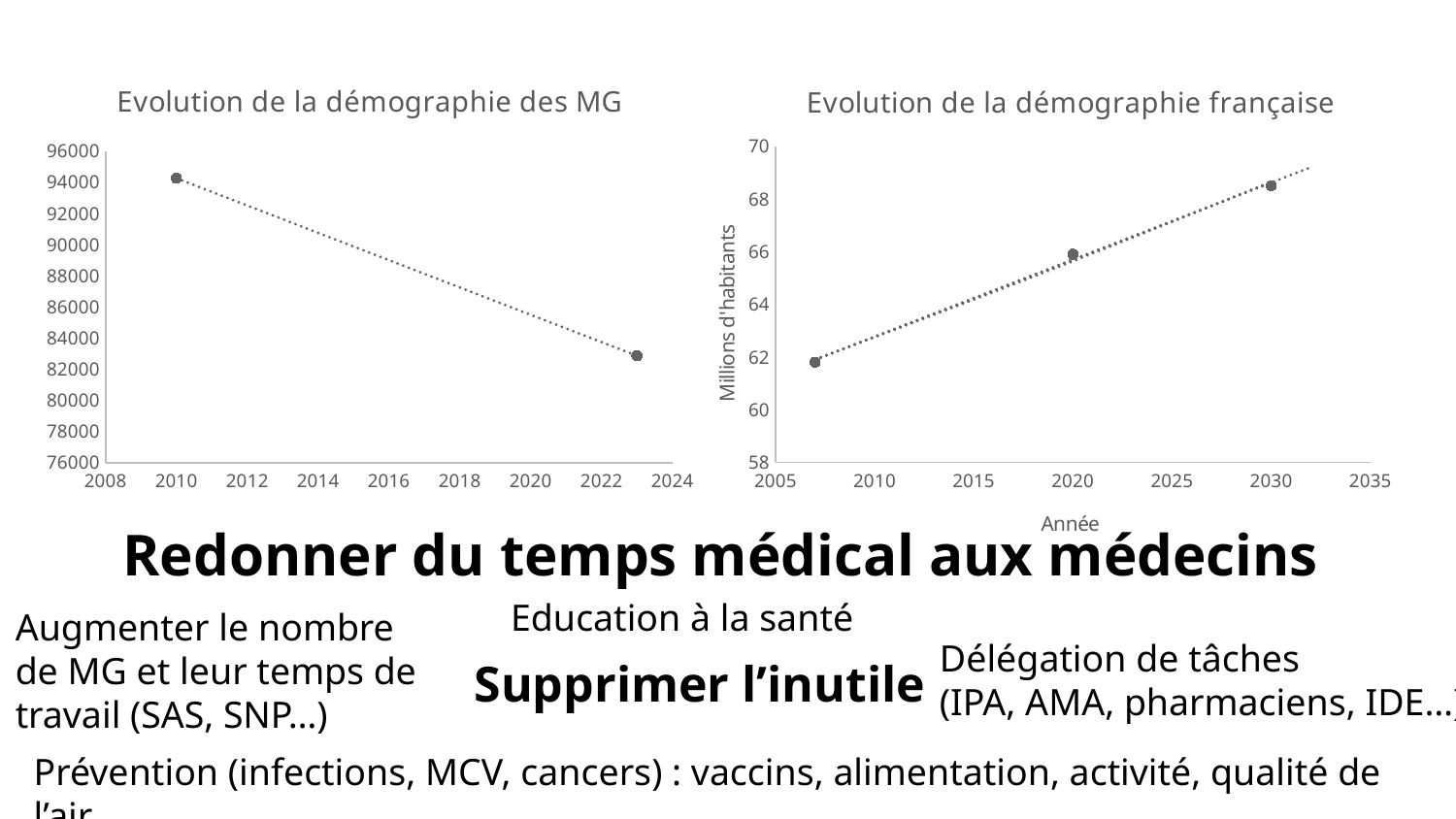
What is the title of the chart on the left of the slide? Evolution de la démographie des MG In the chart titled "Evolution de la démographie française", is the value for 2030 greater or less than 68? greater In the chart titled "Evolution de la démographie française", what is the label of the vertical axis? Millions d'habitants In the chart titled "Evolution de la démographie des MG", is the value for 2010 greater or less than 92000? greater In the chart titled "Evolution de la démographie française", how many data points are plotted? 3 In the chart titled "Evolution de la démographie des MG", how many data points are plotted? 2 In the chart titled "Evolution de la démographie des MG", is the value for the 2023 point greater or less than 84000? less In the chart titled "Evolution de la démographie française", which is larger, the value for 2020 or the value for 2030? 2030 In the chart titled "Evolution de la démographie des MG", what kind of chart is it? scatter chart In the chart titled "Evolution de la démographie des MG", do the values rise or fall from 2010 to 2023? fall In the chart titled "Evolution de la démographie française", do the values rise or fall over the years? rise